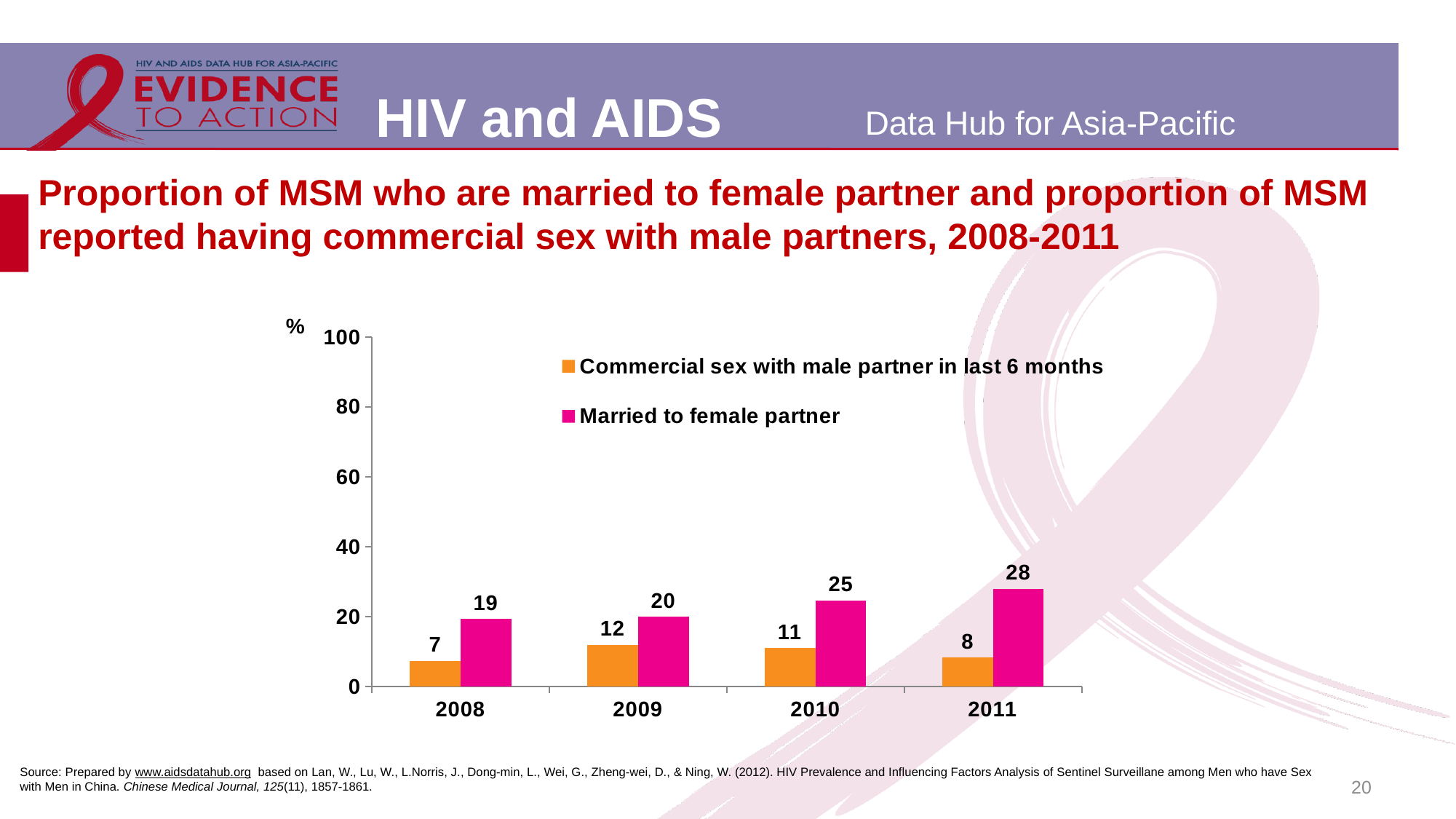
Does 'Married to female partner' rise or fall from 2008 to 2011? Rise Is the value for 'Married to female partner' in 2011 greater or less than 20? greater What kind of chart is shown on the slide? Bar chart In which year is 'Commercial sex with male partner in last 6 months' lowest? 2008 In which year is 'Married to female partner' highest? 2011 Which is larger in 2009: 'Married to female partner' or 'Commercial sex with male partner in last 6 months'? Married to female partner How many years are shown on the x axis? 4 What is the difference between 'Married to female partner' and 'Commercial sex with male partner in last 6 months' in 2010? 14 What is the value for 'Commercial sex with male partner in last 6 months' in 2009? 12 What is the value for 'Commercial sex with male partner in last 6 months' in 2008? 7 What is the value for 'Married to female partner' in 2011? 28 How many series does the legend list? 2